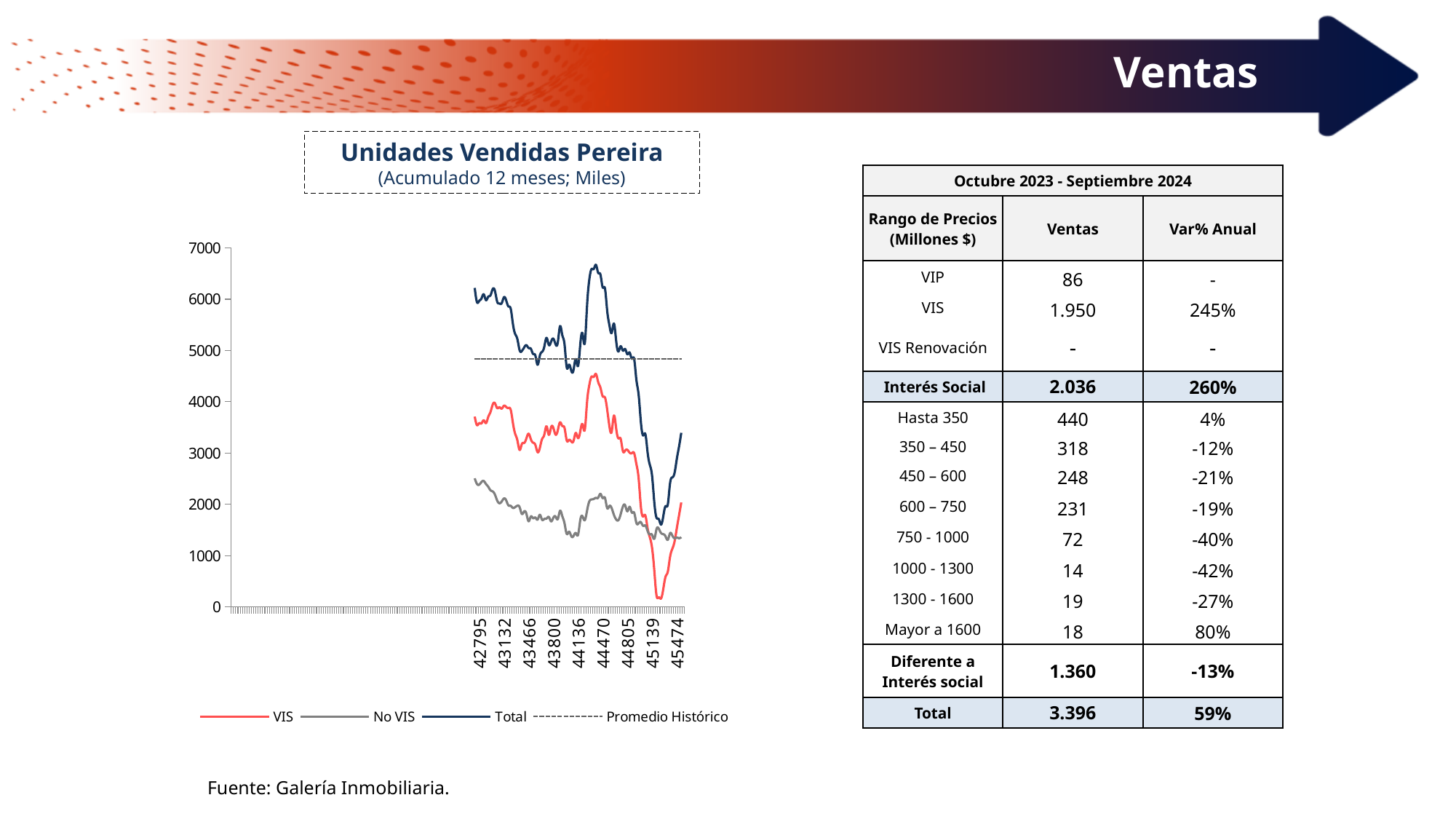
At the lowest point of the VIS series, which is larger: VIS or No VIS? No VIS What kind of chart is shown on the slide? Line chart Which series reaches the highest values in the chart? Total Which series is drawn as a dashed line in the chart? Promedio Histórico Is the Promedio Histórico line greater or less than 4000? greater Is the first value of the No VIS series greater or less than 2000? greater Is the lowest value of the VIS series greater or less than 1000? less At the start of the series, which is larger: VIS or No VIS? VIS How many series does the legend of the chart list? 4 Does the Total series rise or fall between the x-axis labels 44805 and 45139? Fall What is the title of the chart? Unidades Vendidas Pereira